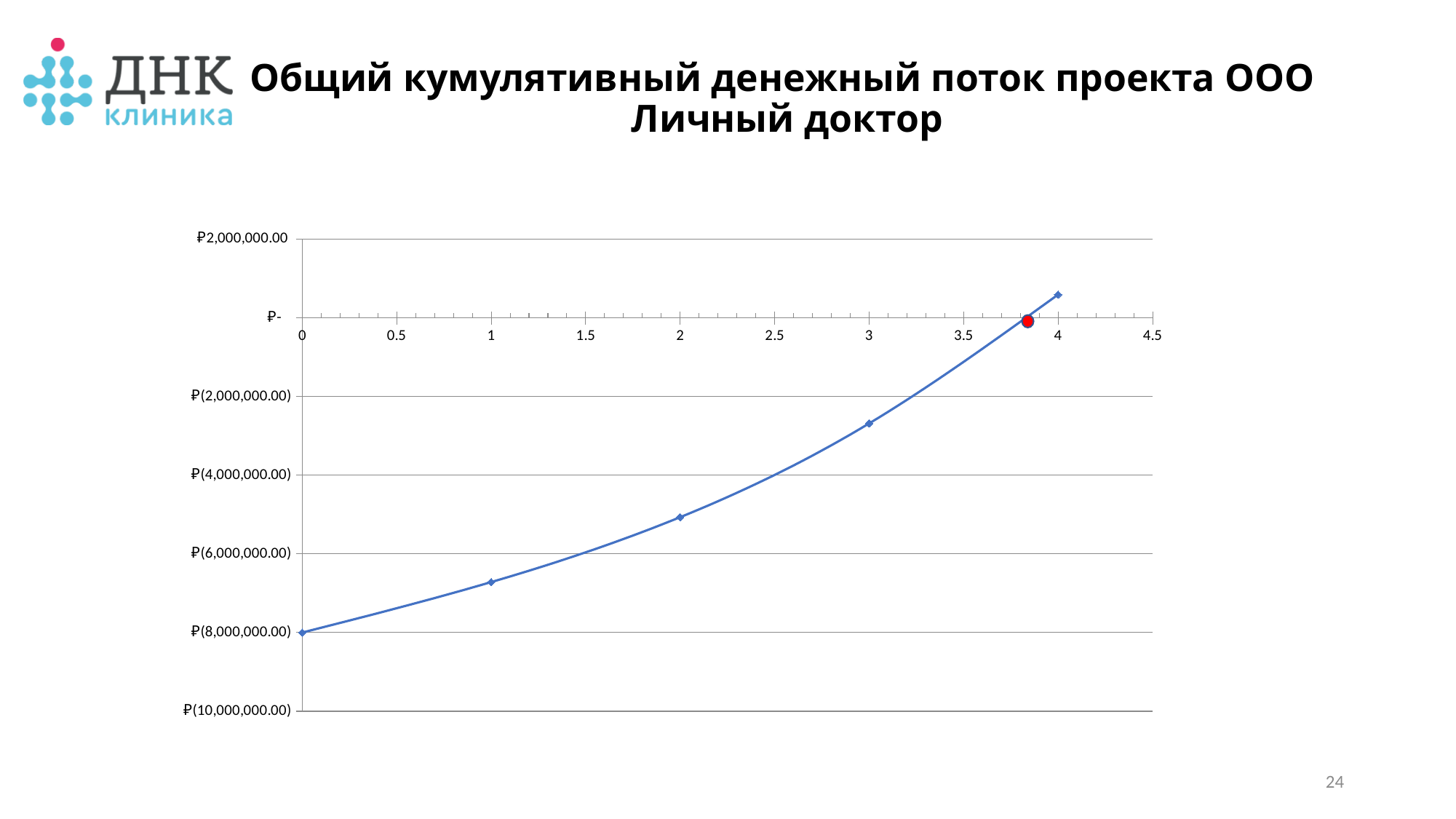
What is the title of the chart on the slide? Общий кумулятивный денежный поток проекта ООО Личный доктор Which is larger, the value at x = 2 or the value at x = 3? x = 3 Do the values rise or fall as x increases from 0 to 4? rise What is the cumulative cash flow value at x = 0? ₽(8,000,000.00) How many data points are plotted on the line? 5 Is the value at x = 2 greater or less than ₽(6,000,000.00)? greater At which x value is the cumulative cash flow highest? 4 Is the value at x = 4 greater or less than ₽-? greater Is the value at x = 1 greater or less than ₽(6,000,000.00)? less At which x value is the cumulative cash flow lowest? 0 What kind of chart is shown on the slide? line chart